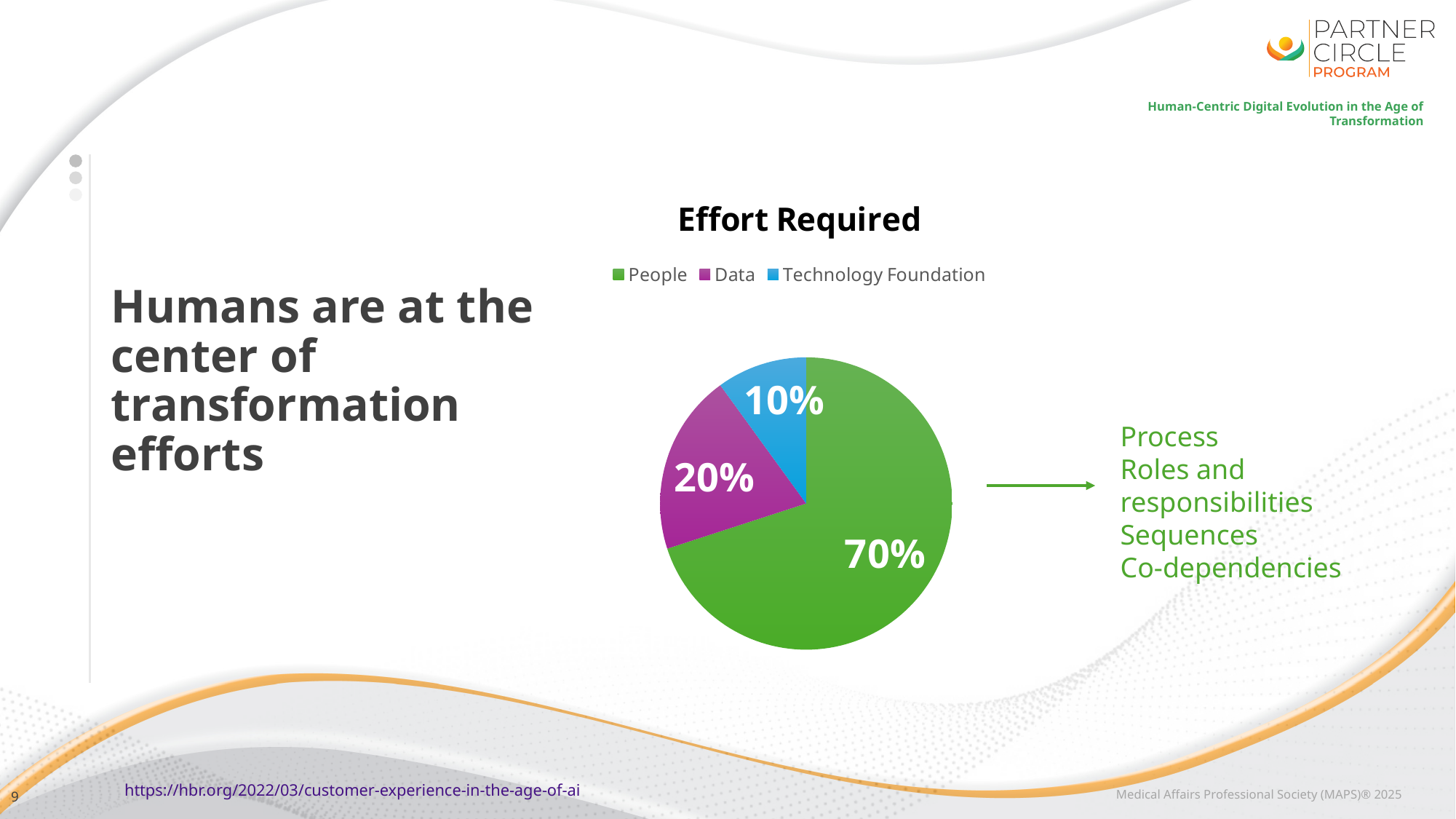
How many slices does the pie chart have? 3 What share of the pie does People account for? 70% What is the difference in percentage points between the People slice and the Data slice? 50 What share of the pie does Data account for? 20% What is the title of the chart? Effort Required Which is larger, the Data slice or the Technology Foundation slice? Data Which category has the largest slice of the pie? People Which category has the smallest slice of the pie? Technology Foundation What type of chart is shown under the title "Effort Required"? pie chart How many categories does the legend list? 3 What share of the pie does Technology Foundation account for? 10% What colour is the People slice? green